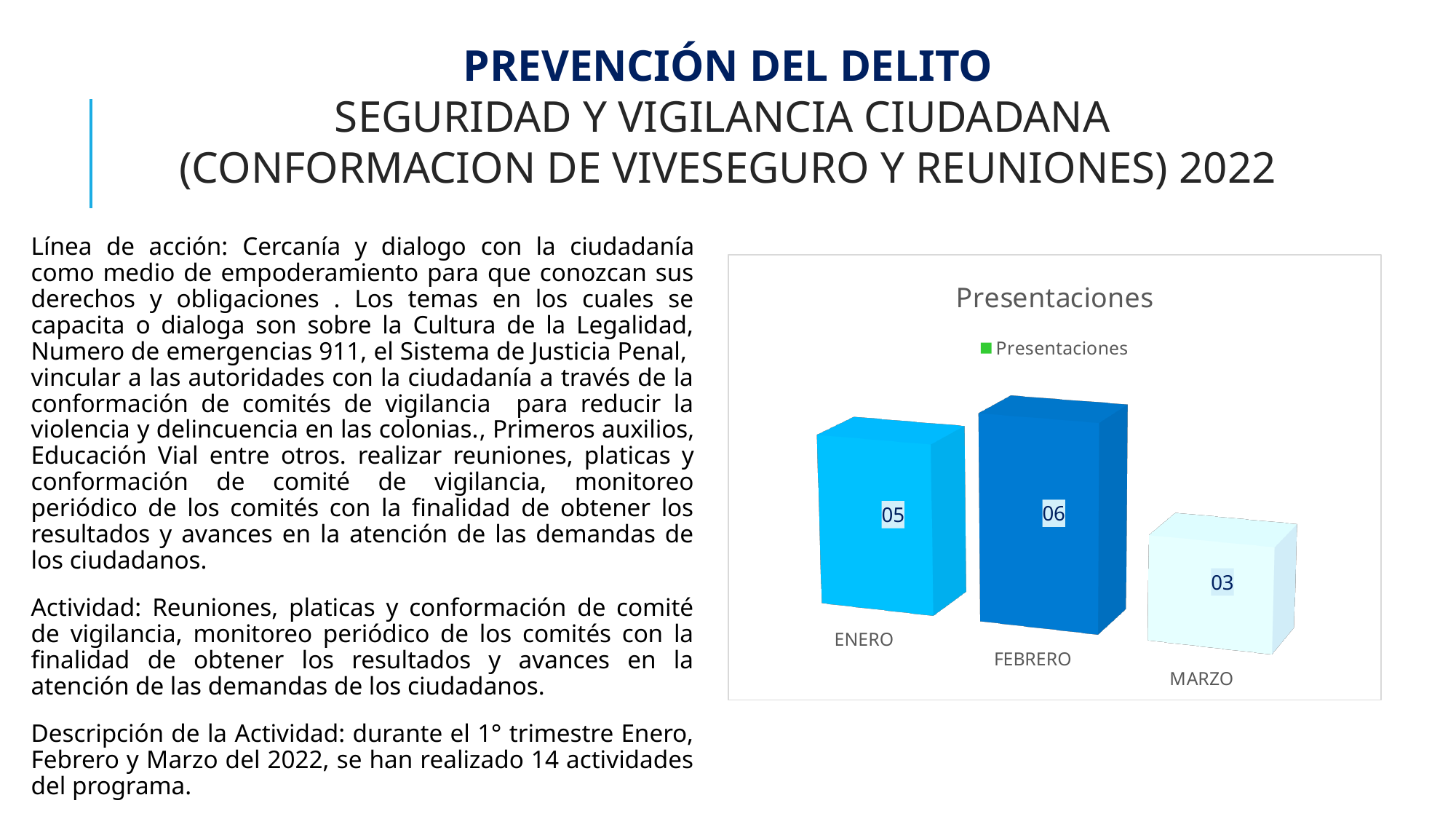
How many months are shown in the Presentaciones chart? 3 What is the value for FEBRERO in the Presentaciones chart? 06 What is the value for MARZO in the Presentaciones chart? 03 Which month has the highest value in the Presentaciones chart? FEBRERO What kind of chart is shown on the slide? Bar chart What is the difference between the values for FEBRERO and MARZO? 3 What is the value for ENERO in the Presentaciones chart? 05 What is the difference between the values for ENERO and MARZO? 2 How many series does the legend of the chart list? 1 Which month has the lowest value in the Presentaciones chart? MARZO What is the title of the chart on the slide? Presentaciones Which is larger, the value for ENERO or the value for FEBRERO? FEBRERO